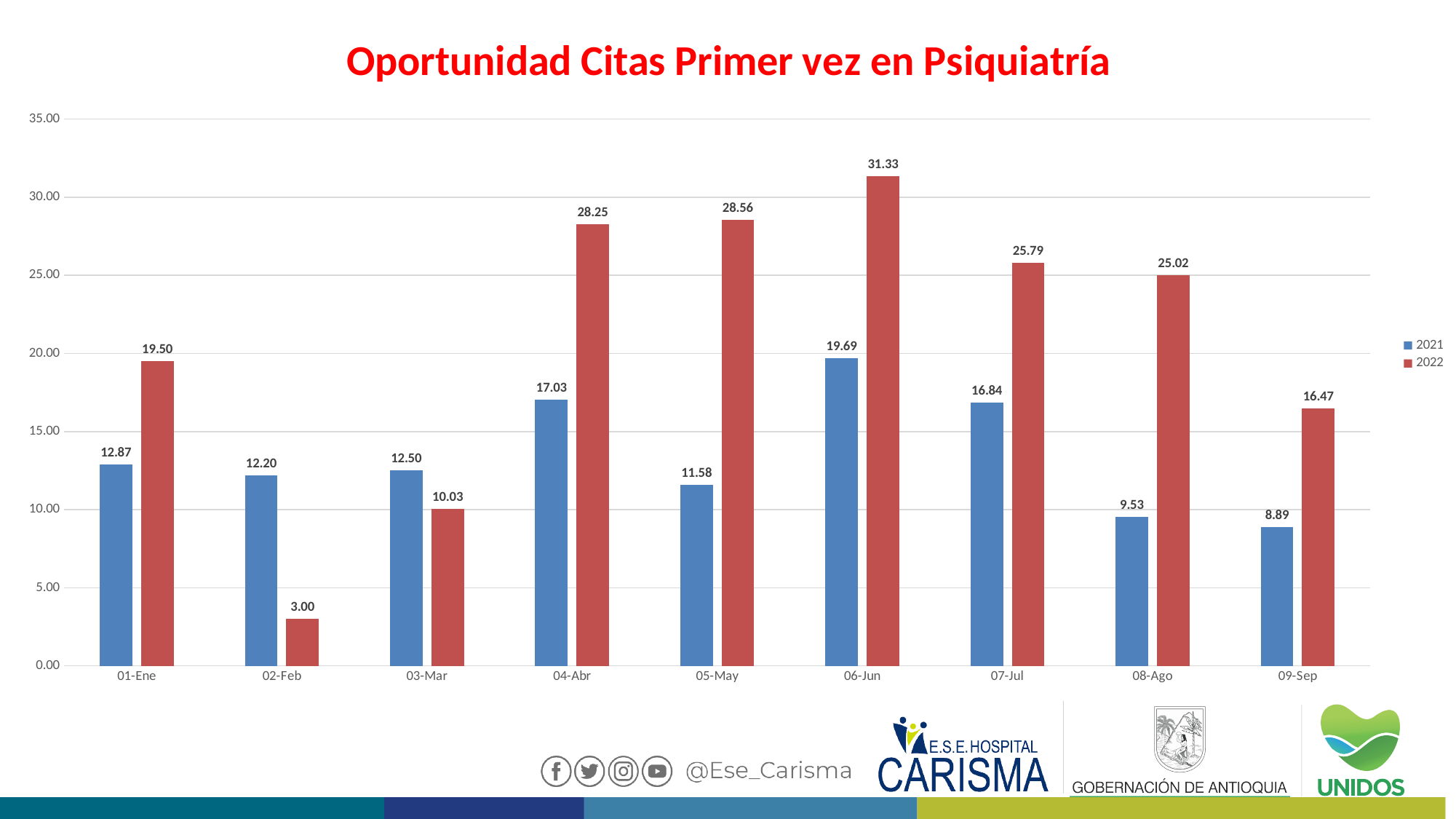
Which month has the lowest value for the 2021 series? 09-Sep In 03-Mar, which series has the larger value, 2021 or 2022? 2021 What is the value for 2022 in 06-Jun? 31.33 What is the difference between the 2022 and 2021 values in 05-May? 16.98 What is the value for 2021 in 04-Abr? 17.03 Which month has the highest value for the 2021 series? 06-Jun What kind of chart is shown on the slide? Bar chart What is the value for 2022 in 02-Feb? 3.00 How many months are shown on the x axis? 9 How many series does the legend list? 2 Which month has the lowest value for the 2022 series? 02-Feb What is the title of the chart? Oportunidad Citas Primer vez en Psiquiatría